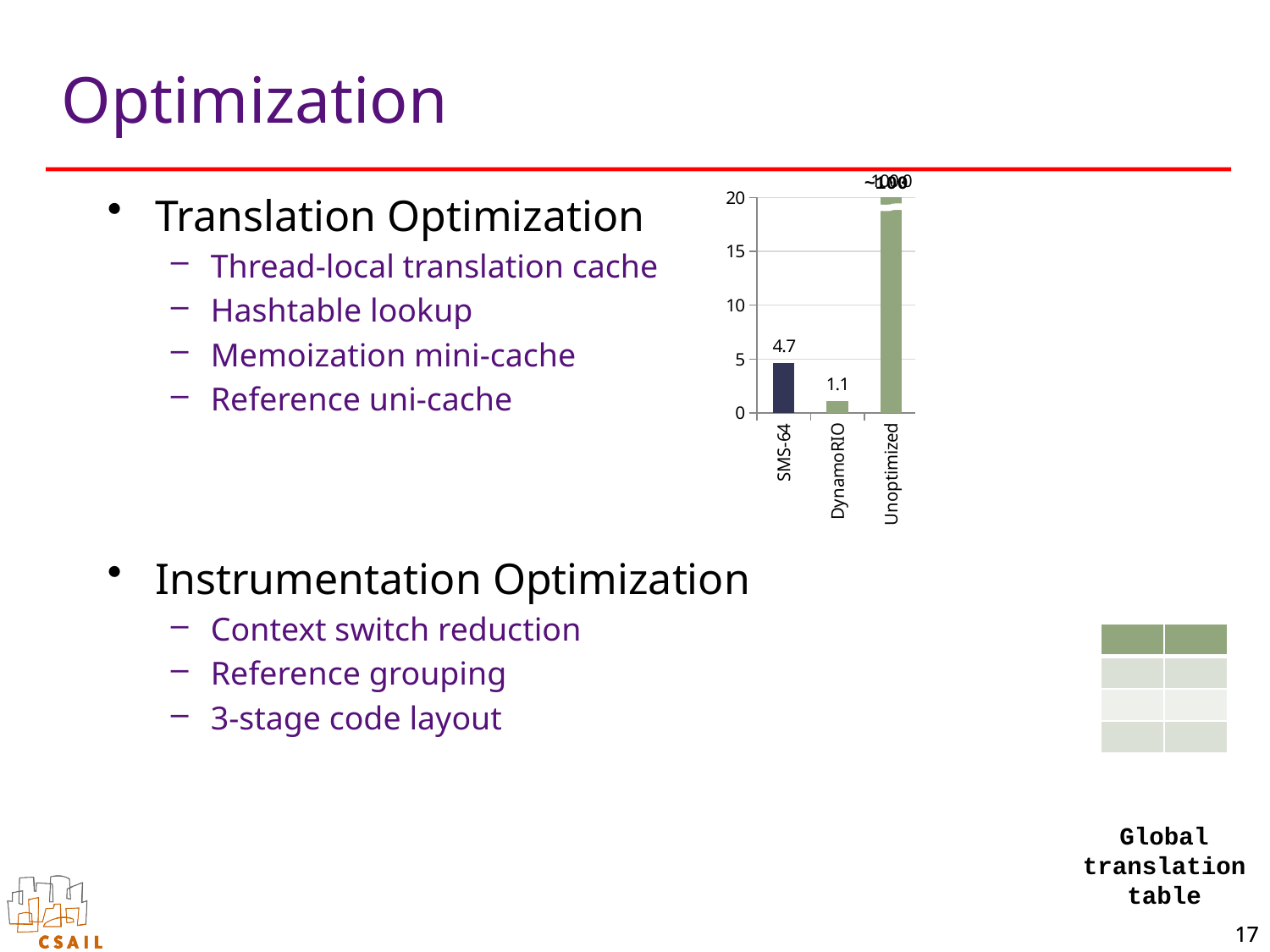
What is the value for DynamoRIO in the bar chart? 1.1 What kind of chart is shown on the slide? bar chart What is the difference between the values for SMS-64 and DynamoRIO? 3.6 What is the highest tick value shown on the vertical axis of the chart? 20 Which category has the highest value in the bar chart? Unoptimized Is the value for Unoptimized greater or less than 15? greater What is the value for SMS-64 in the bar chart? 4.7 Is the value for DynamoRIO greater or less than 5? less How many categories are shown in the bar chart? 3 Is the value for SMS-64 greater or less than 5? less Which category has the lowest value in the bar chart? DynamoRIO Which is larger, the value for SMS-64 or the value for DynamoRIO? SMS-64